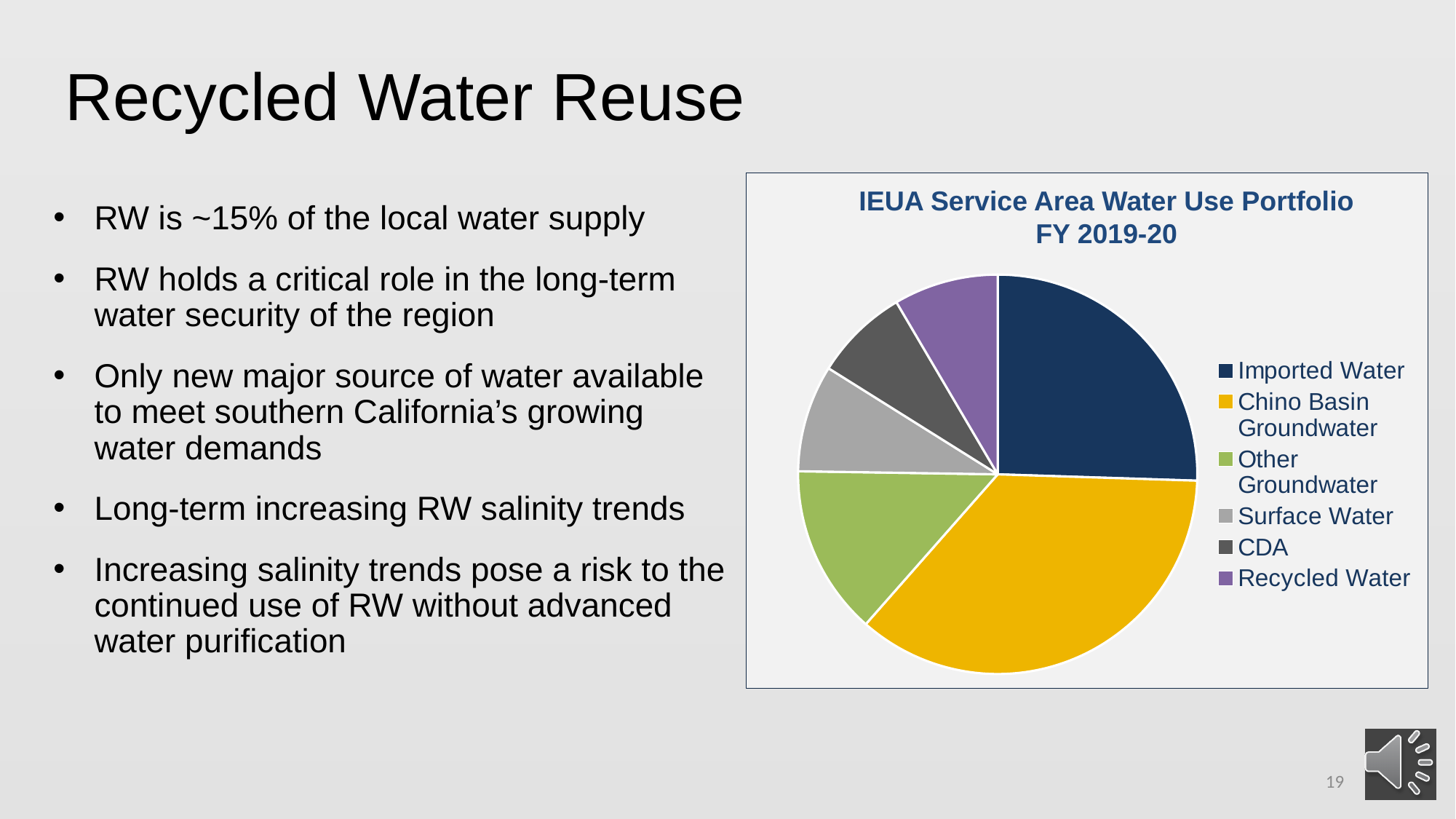
Which slice is larger, Chino Basin Groundwater or Imported Water? Chino Basin Groundwater Which category has the largest slice of the pie? Chino Basin Groundwater Which slice is larger, Imported Water or Surface Water? Imported Water Which slice is larger, Imported Water or Other Groundwater? Imported Water What is the title of the chart? IEUA Service Area Water Use Portfolio FY 2019-20 How many slices does the pie chart have? 6 What kind of chart is shown on the slide? pie chart How many entries does the chart legend list? 6